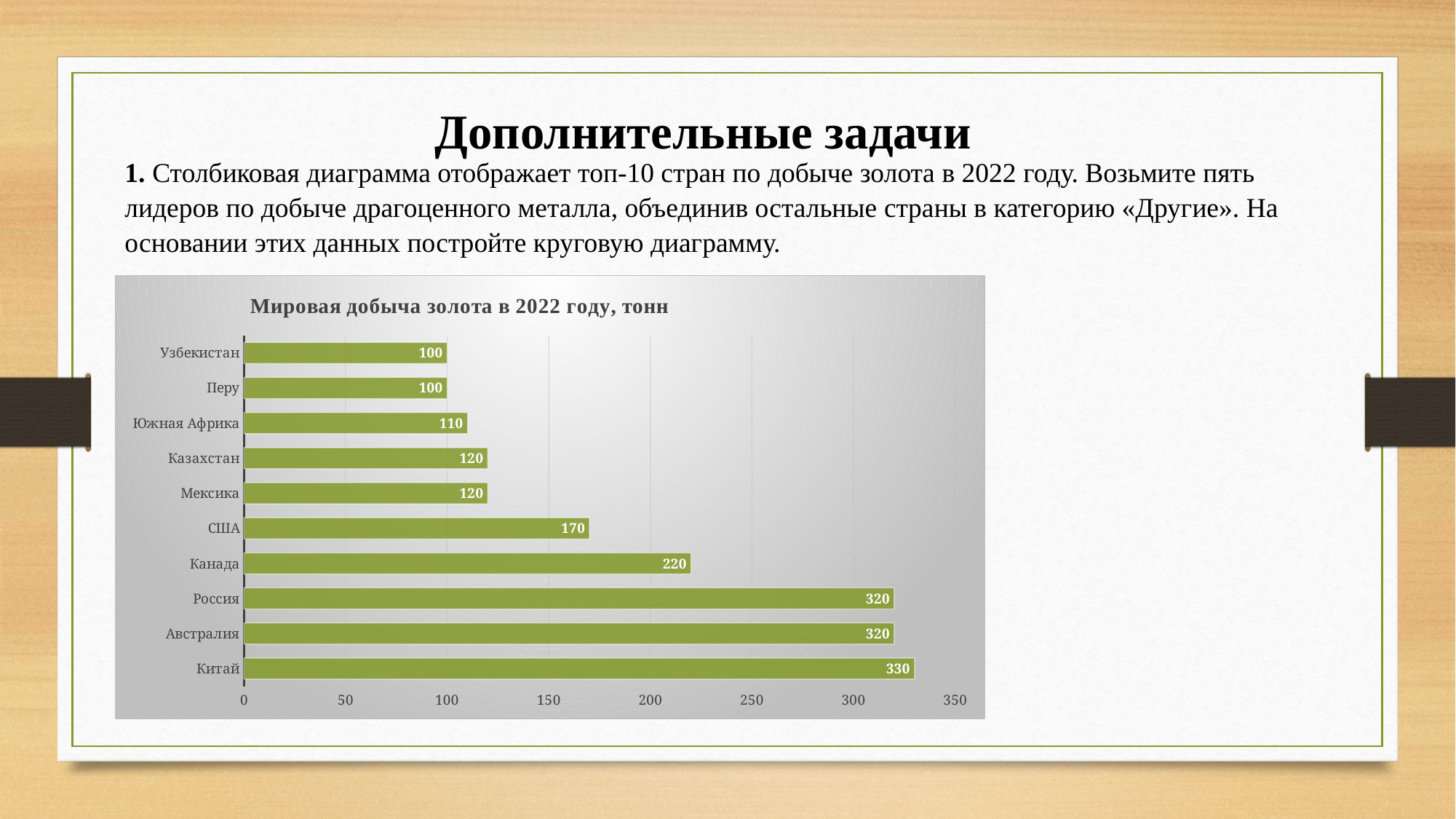
What is the value for Канада? 220 How many countries are shown in the chart? 10 Which is larger, the value for Канада or the value for США? Канада What kind of chart is shown on the slide? bar chart Is the value for Австралия greater or less than 300? greater What is the difference between the values for Россия and Канада? 100 Which country has the highest value? Китай What is the difference between the values for Китай and Узбекистан? 230 What is the value for США? 170 What is the value for Китай? 330 What is the value for Южная Африка? 110 What is the title of the chart? Мировая добыча золота в 2022 году, тонн